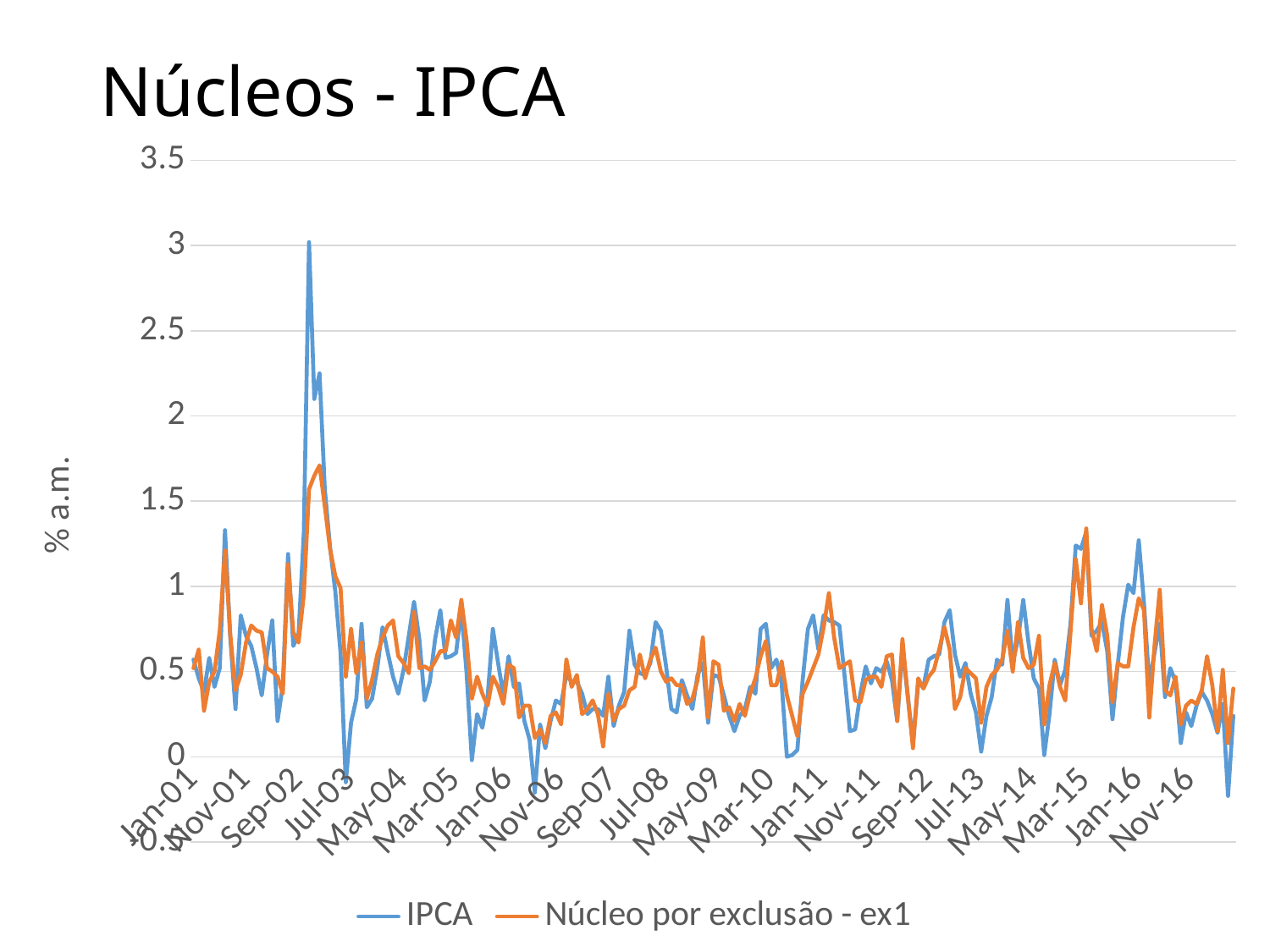
How many date labels are shown on the x axis? 20 Which series reaches the highest peak on the chart? IPCA Is the highest value of the Núcleo por exclusão - ex1 series greater or less than 1.5? greater Is the highest value of the IPCA series greater or less than 2.5? greater Does the IPCA series rise or fall between its peak near Jan-03 and Jul-03? fall Around the peak near Jan-03, which series has the larger value, IPCA or Núcleo por exclusão - ex1? IPCA Is the highest value of the Núcleo por exclusão - ex1 series greater or less than 2? less Which series is drawn in orange? Núcleo por exclusão - ex1 How many series does the legend list? 2 What kind of chart is shown on the slide? line chart What is the title of the chart? Núcleos - IPCA